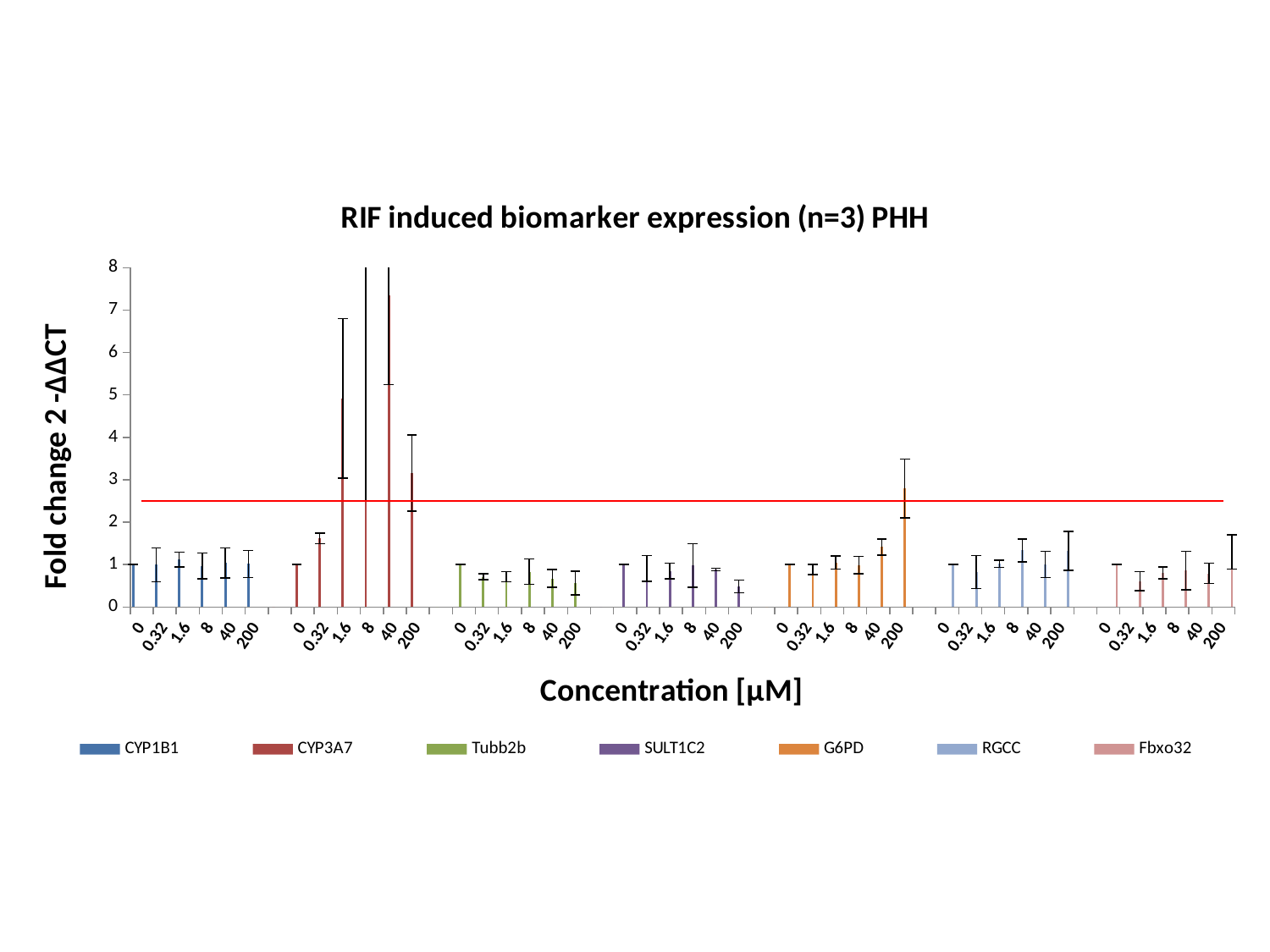
Is the value for Tubb2b at 200 µM greater or less than 1? less How many series does the legend list? 7 What kind of chart is shown on the slide? bar chart What is the title of the chart? RIF induced biomarker expression (n=3) PHH What is the label of the x axis? Concentration [µM] Is the value for CYP3A7 at 8 µM greater or less than 4? greater Is the value for G6PD at 200 µM greater or less than 2? greater How many concentration levels are plotted for each series? 6 Which is larger, the value for CYP3A7 at 40 µM or the value for RGCC at 40 µM? CYP3A7 at 40 µM Which series has the highest bar in the chart? CYP3A7 What is the value for CYP1B1 at 0 µM? 1